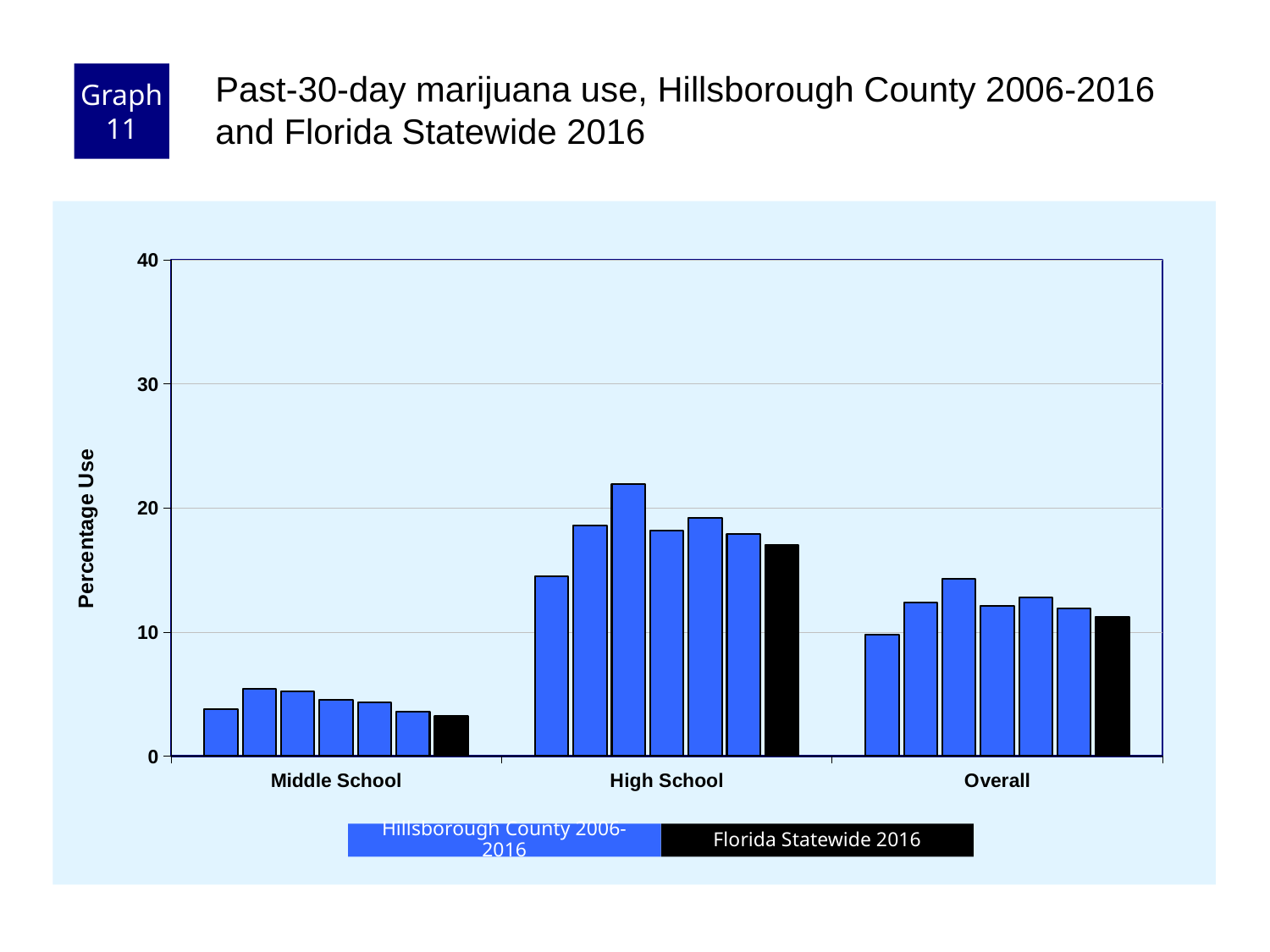
Which category has the highest bars? High School Is the Florida Statewide 2016 value for High School greater or less than 20? less How many series does the legend list? 2 Is the Florida Statewide 2016 value for High School greater or less than 10? greater Is the tallest Hillsborough County bar for High School greater or less than 20? greater Which series is shown in black? Florida Statewide 2016 How many categories are shown on the x axis? 3 Which is larger, the Florida Statewide 2016 value for High School or for Overall? High School Which category has the lowest bars? Middle School What is the label of the y axis? Percentage Use What kind of chart is shown on the slide? bar chart